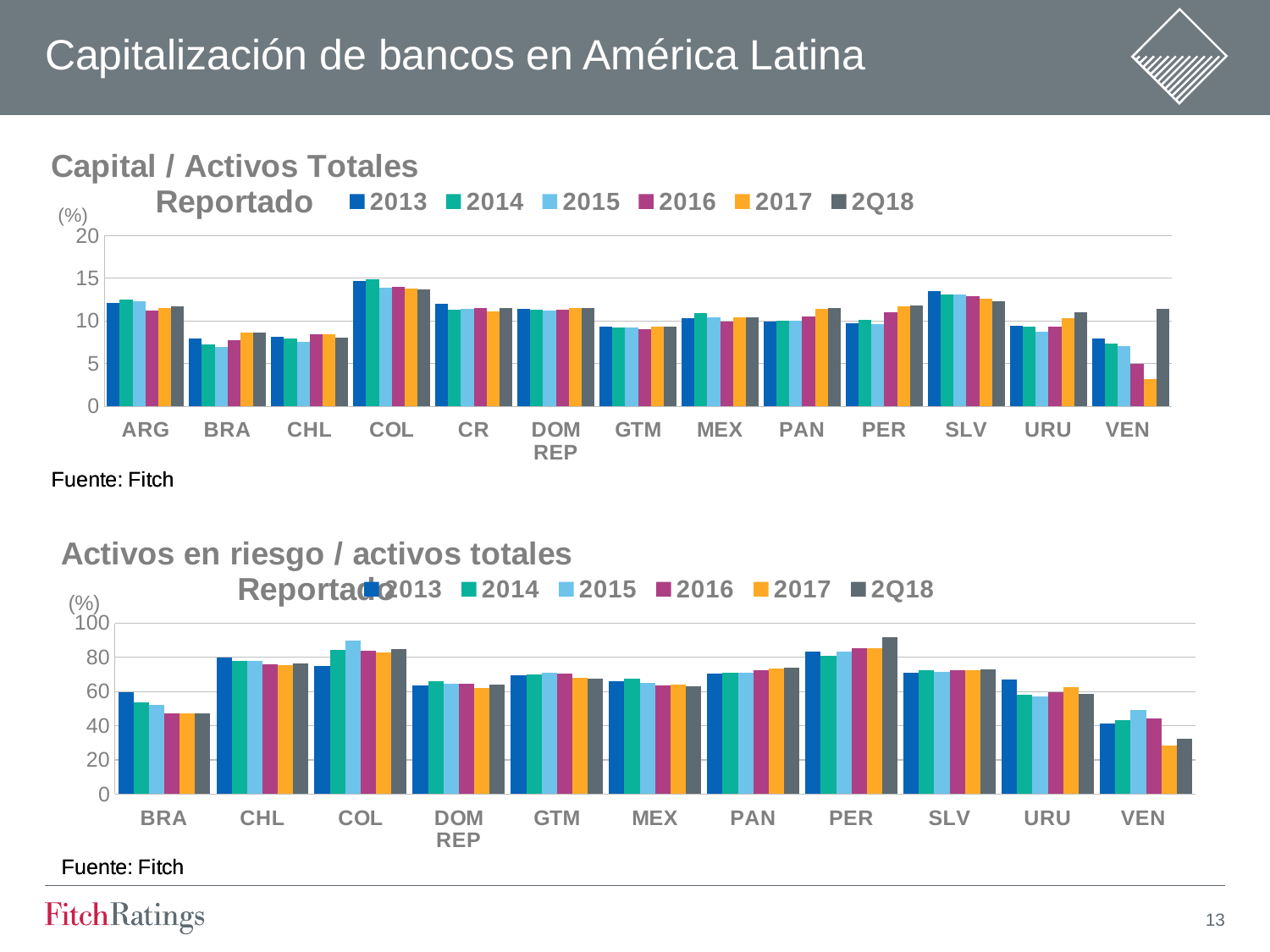
How many series does the legend of the top chart 'Capital / Activos Totales Reportado' list? 6 How many countries are shown on the x axis of the top chart 'Capital / Activos Totales Reportado'? 13 How many countries are shown on the x axis of the bottom chart 'Activos en riesgo / activos totales Reportado'? 11 What kind of chart is the top chart titled 'Capital / Activos Totales Reportado'? bar chart In the bottom chart 'Activos en riesgo / activos totales Reportado', is the 2017 value for VEN greater or less than 40? less In the top chart 'Capital / Activos Totales Reportado', which country has the highest 2013 value? COL In the top chart 'Capital / Activos Totales Reportado', is the 2013 value for COL greater or less than 10? greater In the bottom chart 'Activos en riesgo / activos totales Reportado', which is larger, the 2013 value for CHL or the 2013 value for URU? CHL In the top chart 'Capital / Activos Totales Reportado', do the values for VEN rise or fall from 2013 to 2017? fall In the top chart 'Capital / Activos Totales Reportado', is the 2017 value for VEN greater or less than 5? less In the bottom chart 'Activos en riesgo / activos totales Reportado', which country has the highest 2Q18 value? PER In the top chart 'Capital / Activos Totales Reportado', which country has the lowest 2017 value? VEN